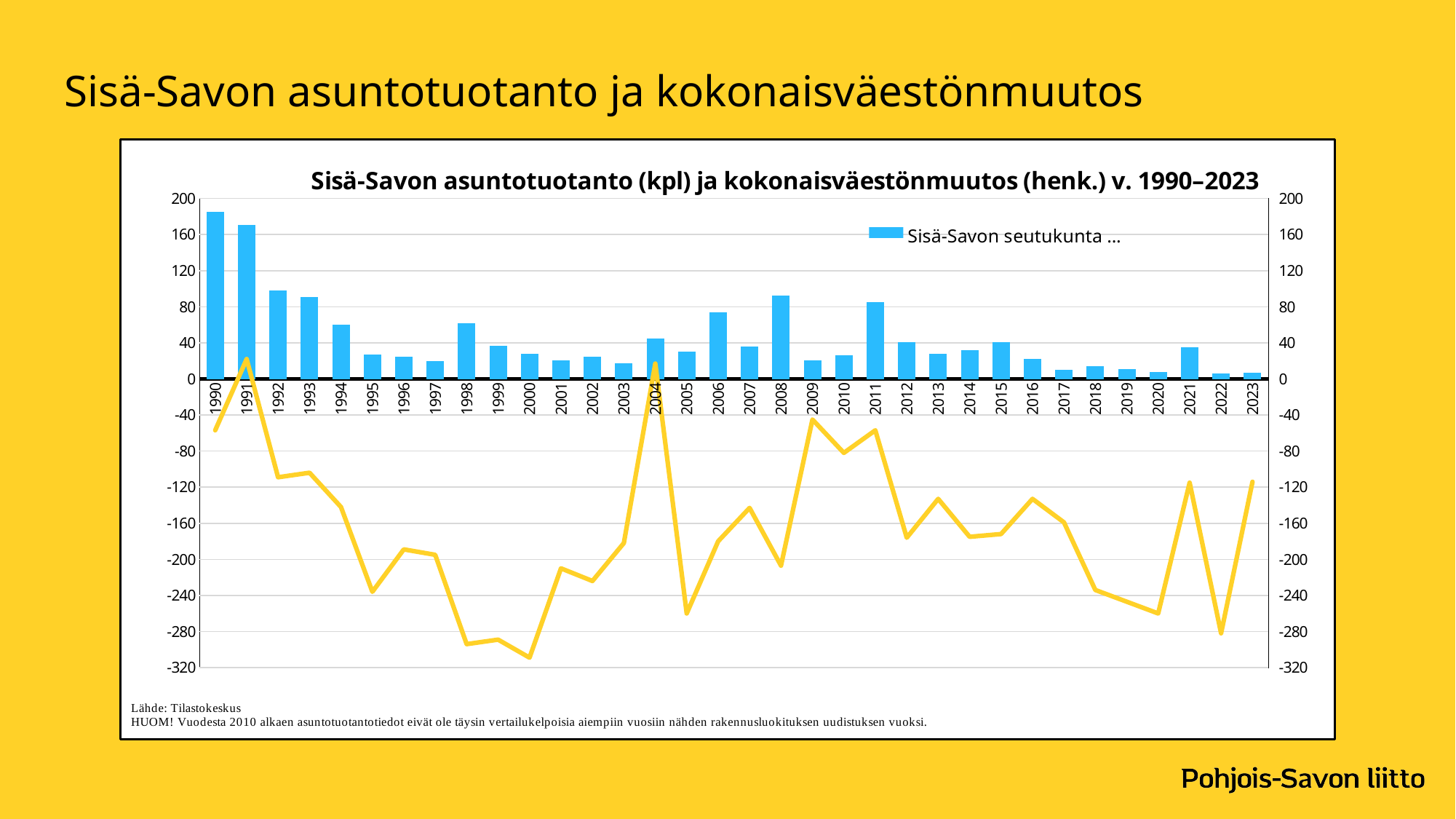
Which year has the tallest bar in the chart? 1990 Do the bar values rise or fall from 1990 to 1993? fall What is the title of the chart? Sisä-Savon asuntotuotanto (kpl) ja kokonaisväestönmuutos (henk.) v. 1990–2023 Is the bar value for 2000 greater or less than 40? less Which year has the lowest point on the yellow line? 2000 Is the line value for 2000 greater or less than -280? less Which bar is taller, 1990 or 2011? 1990 Is the bar value for 1990 greater or less than 160? greater How many years are shown on the x axis of the chart? 34 What kind of chart is shown on the slide? A combined bar and line chart